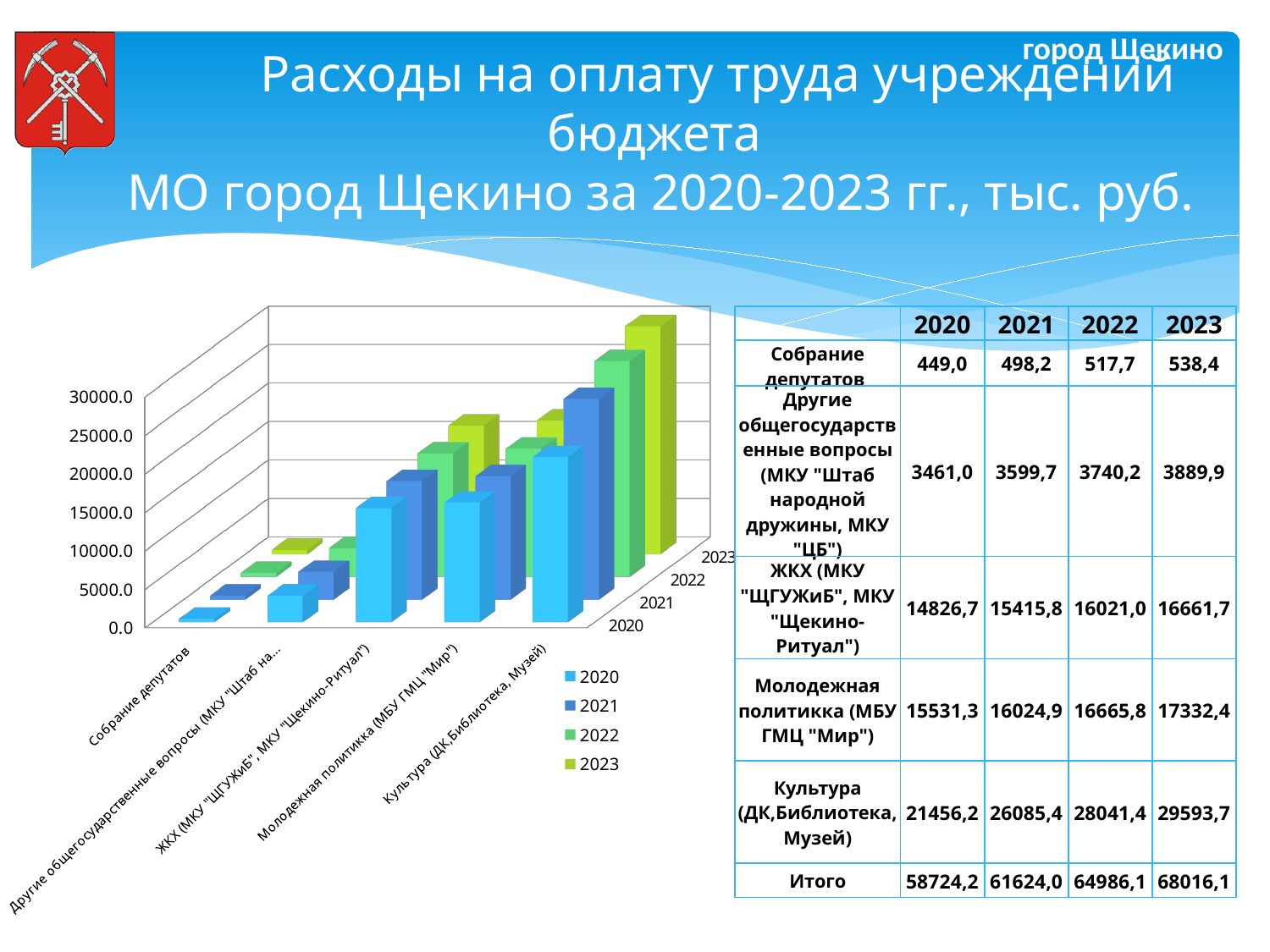
Do the values for Культура (ДК, Библиотека, Музей) rise or fall from 2020 to 2023? rise Which is larger for 2023: Молодежная политика (МБУ ГМЦ "Мир") or ЖКХ (МКУ "ЩГУЖиБ", МКУ "Щекино-Ритуал")? Молодежная политика (МБУ ГМЦ "Мир") What is the difference between the 2023 and 2020 values for Собрание депутатов? 89,4 Which category has the lowest value in 2020? Собрание депутатов What is the value for Собрание депутатов in 2021? 498,2 How many categories are shown on the chart's x axis? 5 Which category has the highest value in 2023? Культура (ДК, Библиотека, Музей) How many series does the chart legend list? 4 What kind of chart is shown on the slide? bar chart What is the value for ЖКХ (МКУ "ЩГУЖиБ", МКУ "Щекино-Ритуал") in 2022? 16021,0 Is the value for Культура (ДК, Библиотека, Музей) in 2020 greater or less than 20000.0? greater What is the value for Культура (ДК, Библиотека, Музей) in 2023? 29593,7